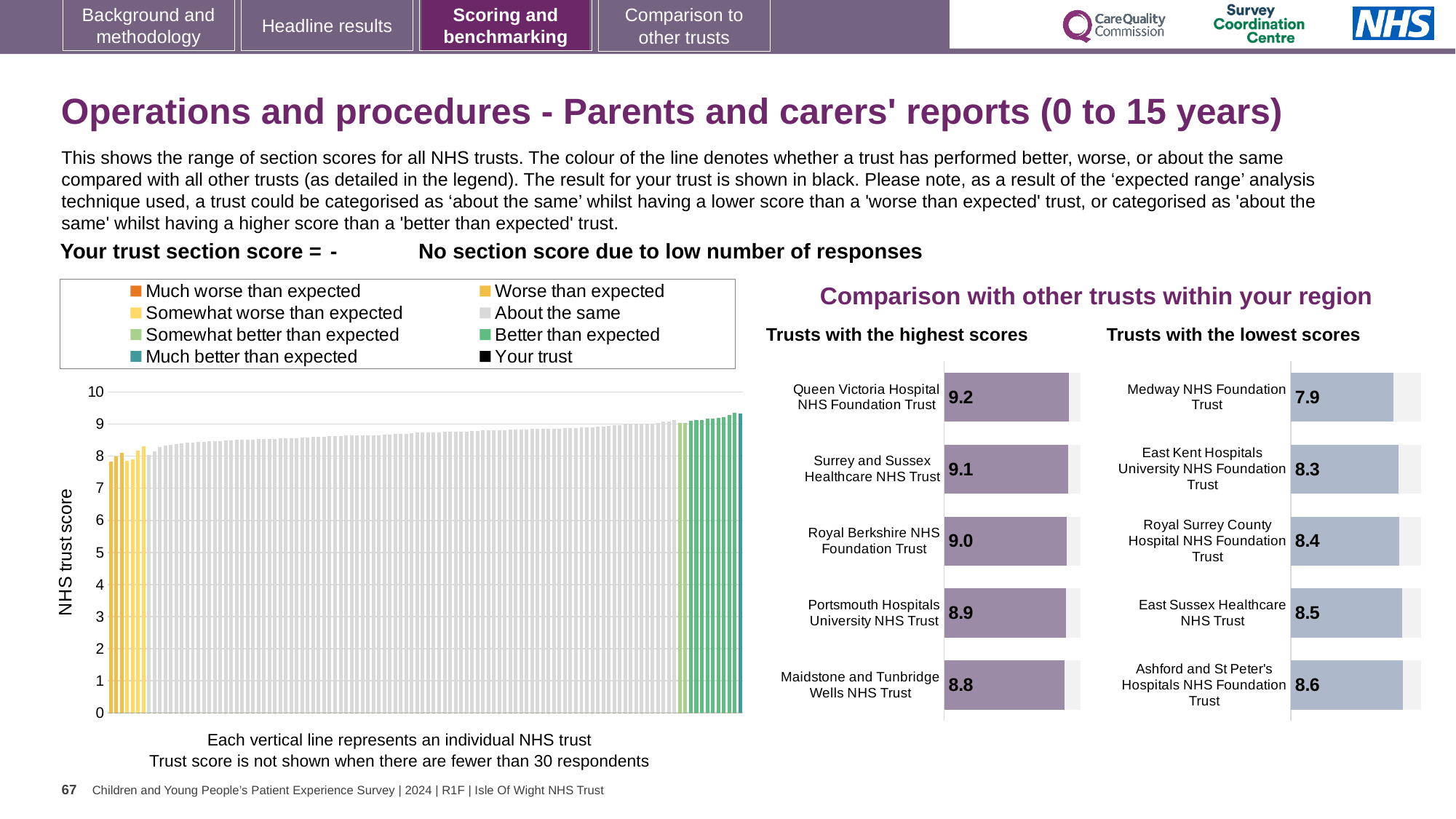
In the 'Trusts with the lowest scores' chart, what is the score for Medway NHS Foundation Trust? 7.9 In the 'Trusts with the lowest scores' chart, what is the difference between the scores of Ashford and St Peter's Hospitals NHS Foundation Trust and Medway NHS Foundation Trust? 0.7 What kind of chart is the large chart on the left showing NHS trust scores? Bar chart In the 'Trusts with the highest scores' chart, what is the difference between the scores of Queen Victoria Hospital NHS Foundation Trust and Maidstone and Tunbridge Wells NHS Trust? 0.4 In the 'Trusts with the lowest scores' chart, which trust has the highest score shown? Ashford and St Peter's Hospitals NHS Foundation Trust In the large chart on the left, do the trust scores rise or fall from left to right? Rise Which has a higher score: Royal Berkshire NHS Foundation Trust in the highest scores chart or East Sussex Healthcare NHS Trust in the lowest scores chart? Royal Berkshire NHS Foundation Trust In the large chart on the left, is the value of the leftmost bar greater or less than 9? less How many entries does the legend above the large chart on the left list? 8 In the 'Trusts with the highest scores' chart, what is the score for Queen Victoria Hospital NHS Foundation Trust? 9.2 In the 'Trusts with the highest scores' chart, which trust has the lowest score shown? Maidstone and Tunbridge Wells NHS Trust How many trusts are listed in the 'Trusts with the lowest scores' chart? 5